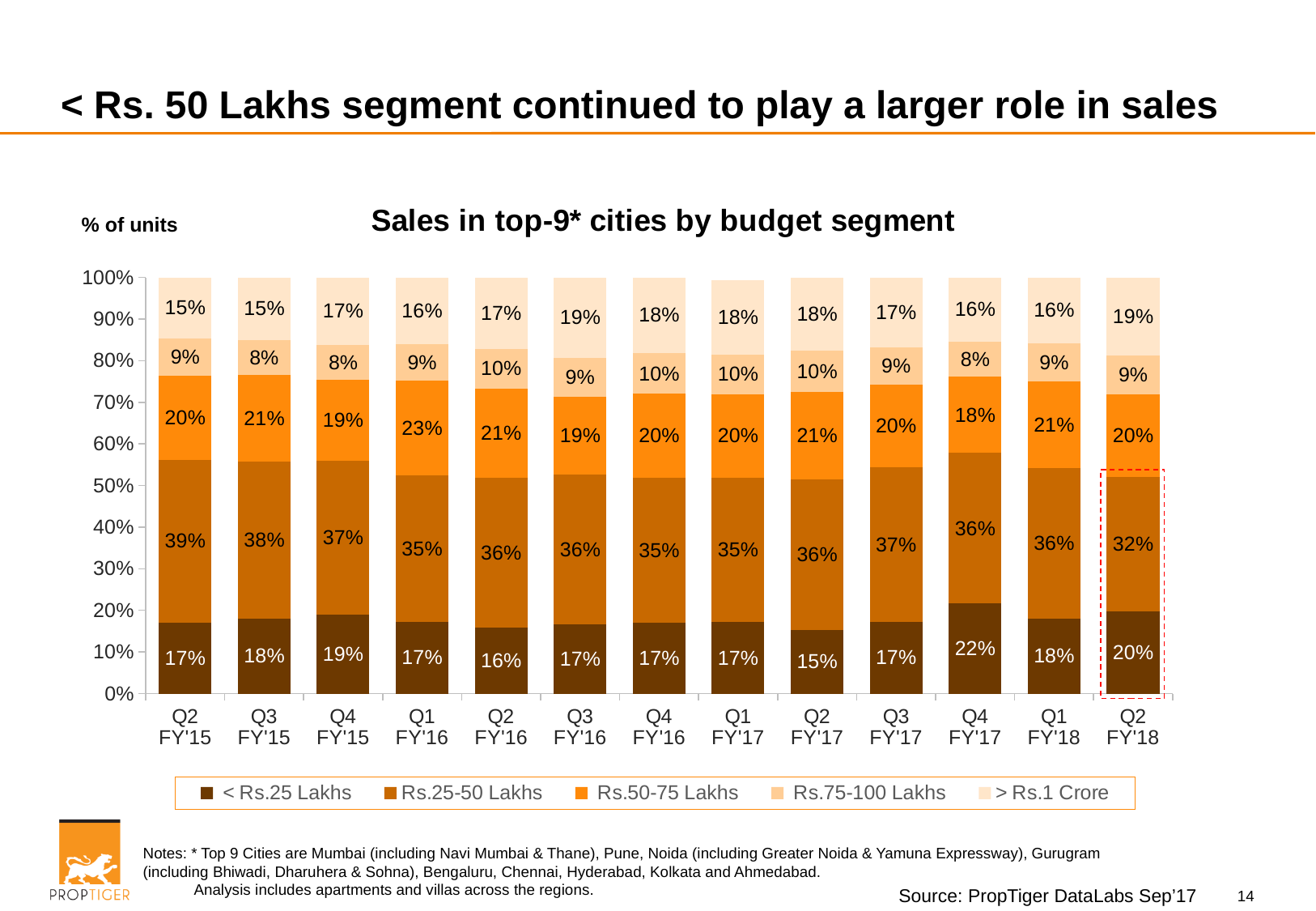
In which quarter was the < Rs.25 Lakhs share the highest? Q4 FY'17 What is the total of the stacked bar for Q2 FY'18? 100% How many quarters are shown on the x axis? 13 What kind of chart is shown on the slide? Stacked bar chart Which is larger: the Rs.50-75 Lakhs share in Q1 FY'16 or in Q4 FY'17? Q1 FY'16 What share of units did the < Rs.25 Lakhs segment account for in Q2 FY'18? 20% What is the difference between the Rs.25-50 Lakhs share in Q2 FY'15 and in Q2 FY'18? 7% What is the title of the chart? Sales in top-9* cities by budget segment What was the Rs.25-50 Lakhs share in Q2 FY'15? 39% What was the > Rs.1 Crore share in Q3 FY'16? 19% How many budget segments does the legend list? 5 In which quarter was the Rs.25-50 Lakhs share the lowest? Q2 FY'18